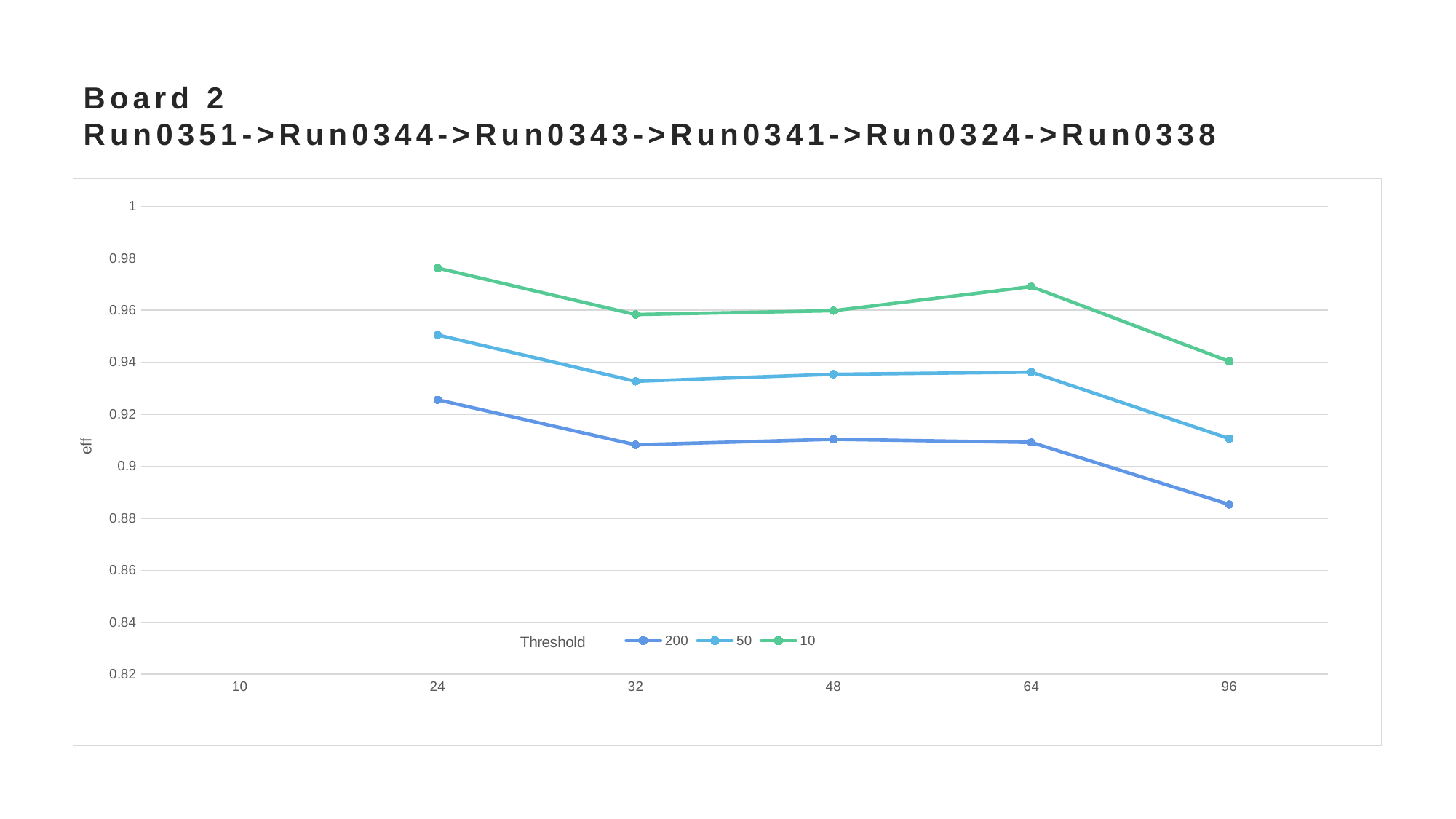
Which series has the lowest values across the chart? 200 What is the label on the y axis? eff Do the values of the 50 series rise or fall between threshold 64 and threshold 96? fall How many series does the legend list? 3 Which series has the highest values across the chart? 10 At which threshold does the 10 series reach its highest value? 24 Is the value for the 200 series at threshold 96 greater or less than 0.9? less For the 10 series, is the value at threshold 64 larger or smaller than at threshold 48? larger At which threshold does the 200 series reach its lowest value? 96 How many data points are plotted for the 200 series? 5 What kind of chart is shown on the slide? line chart Is the value for the 10 series at threshold 24 greater or less than 0.96? greater